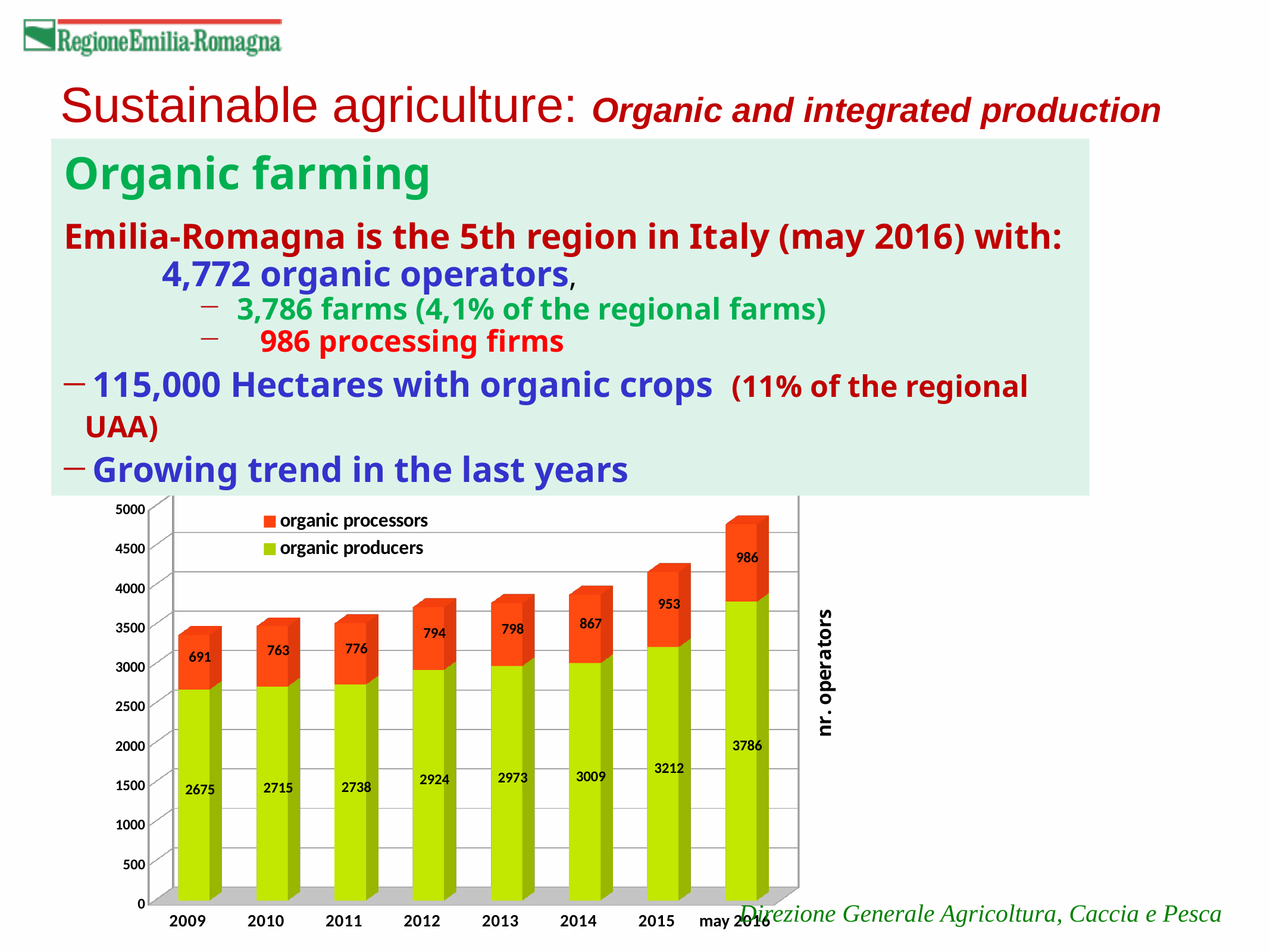
What type of chart is shown on the slide? stacked bar chart Which is larger: organic processors in 2013 or organic processors in 2015? 2015 What is the difference between organic producers in may 2016 and in 2009? 1111 What is the value for organic producers in may 2016? 3786 In which year is the number of organic producers highest? may 2016 What is the value for organic processors in 2014? 867 In which year is the number of organic processors lowest? 2009 How many years (categories) are shown on the x axis of the chart? 8 What is the total number of operators (producers plus processors) in may 2016? 4772 What is the value for organic producers in 2012? 2924 Do the values for organic producers rise or fall from 2009 to may 2016? rise How many series does the chart legend list? 2